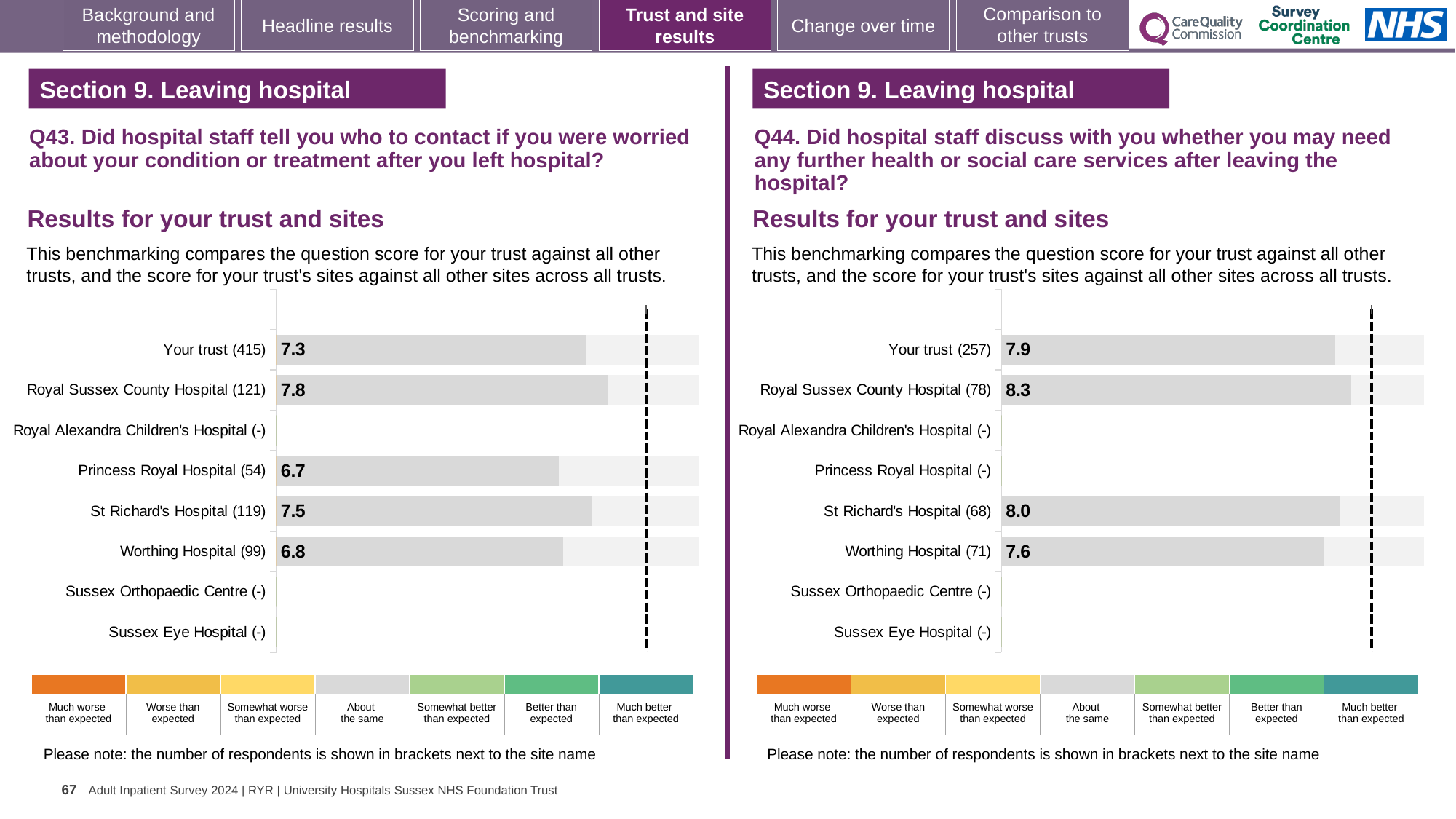
In the Q43 chart on the left, what is the score for Princess Royal Hospital? 6.7 In the Q44 chart on the right, how many sites have a score bar plotted? 3 In the Q43 chart on the left, which site has the highest score? Royal Sussex County Hospital In the Q44 chart on the right, what is the score for Worthing Hospital? 7.6 What kind of chart is used for the Q43 results on the left? Bar chart In the Q43 chart on the left, which site has the lowest score? Princess Royal Hospital In the Q43 chart on the left, how many respondents are shown for St Richard's Hospital? 119 In the Q43 chart on the left, what is the score for Your trust? 7.3 In the Q44 chart on the right, what is the score for Royal Sussex County Hospital? 8.3 In the Q43 chart on the left, what is the difference between the scores for Royal Sussex County Hospital and Worthing Hospital? 1.0 In the Q44 chart on the right, which site has the lowest score? Worthing Hospital In the Q44 chart on the right, which is larger, the score for St Richard's Hospital or Your trust? St Richard's Hospital